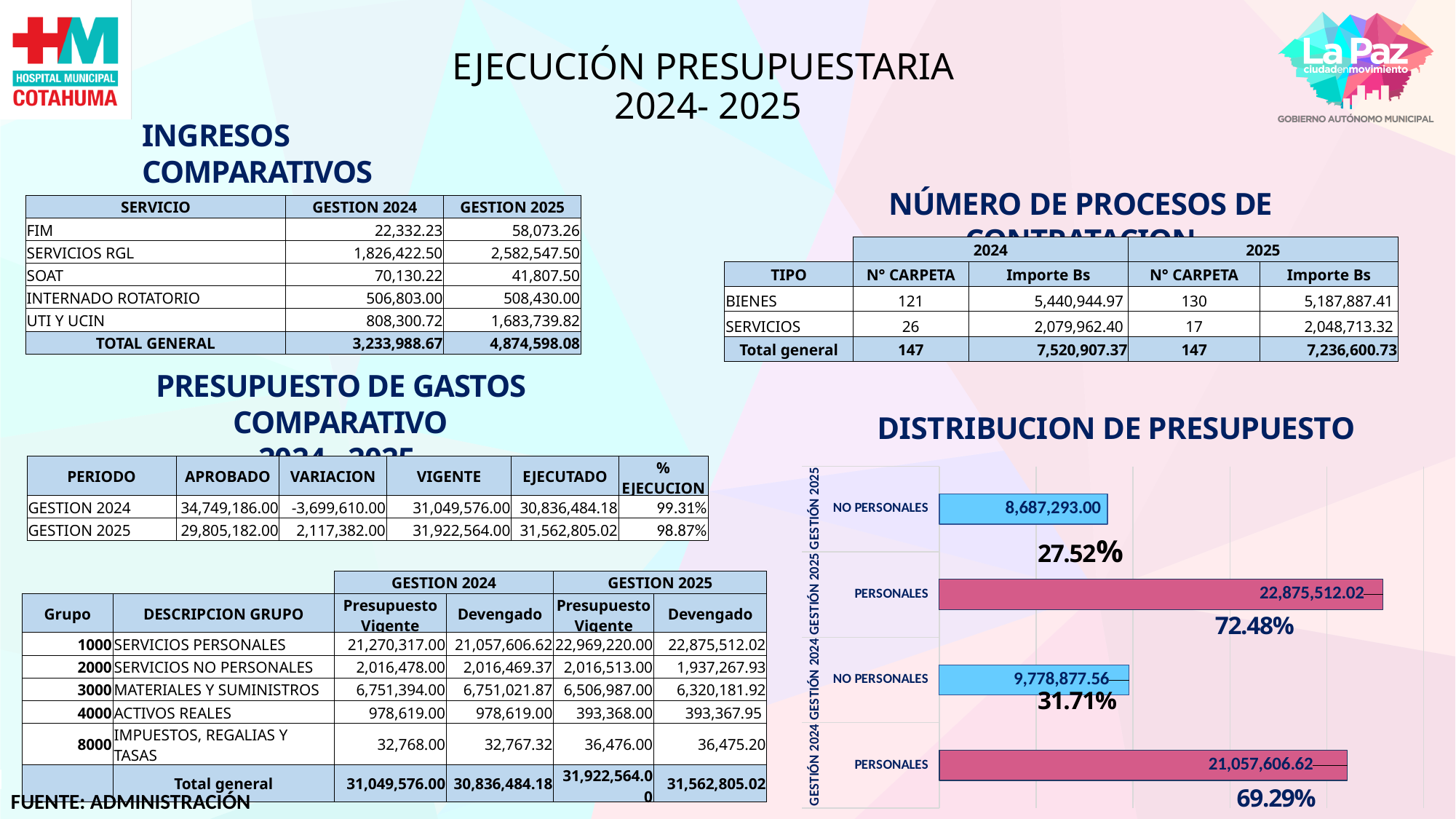
In the DISTRIBUCION DE PRESUPUESTO chart, which bar has the lowest value? NO PERSONALES, GESTIÓN 2025 What type of chart is DISTRIBUCION DE PRESUPUESTO? Bar chart In the DISTRIBUCION DE PRESUPUESTO chart, which is larger: NO PERSONALES in GESTIÓN 2024 or NO PERSONALES in GESTIÓN 2025? NO PERSONALES in GESTIÓN 2024 In the DISTRIBUCION DE PRESUPUESTO chart, what is the difference between PERSONALES in GESTIÓN 2025 and PERSONALES in GESTIÓN 2024? 1,817,905.40 In the DISTRIBUCION DE PRESUPUESTO chart, what percentage is shown for NO PERSONALES in GESTIÓN 2024? 31.71% In the DISTRIBUCION DE PRESUPUESTO chart, what is the value for PERSONALES in GESTIÓN 2025? 22,875,512.02 In the DISTRIBUCION DE PRESUPUESTO chart, what is the value for PERSONALES in GESTIÓN 2024? 21,057,606.62 In the DISTRIBUCION DE PRESUPUESTO chart, what is the value for NO PERSONALES in GESTIÓN 2025? 8,687,293.00 In the DISTRIBUCION DE PRESUPUESTO chart, what percentage is shown for PERSONALES in GESTIÓN 2025? 72.48% In the DISTRIBUCION DE PRESUPUESTO chart, what is the value for NO PERSONALES in GESTIÓN 2024? 9,778,877.56 In the DISTRIBUCION DE PRESUPUESTO chart, which bar has the highest value? PERSONALES, GESTIÓN 2025 How many bars are plotted in the DISTRIBUCION DE PRESUPUESTO chart? 4